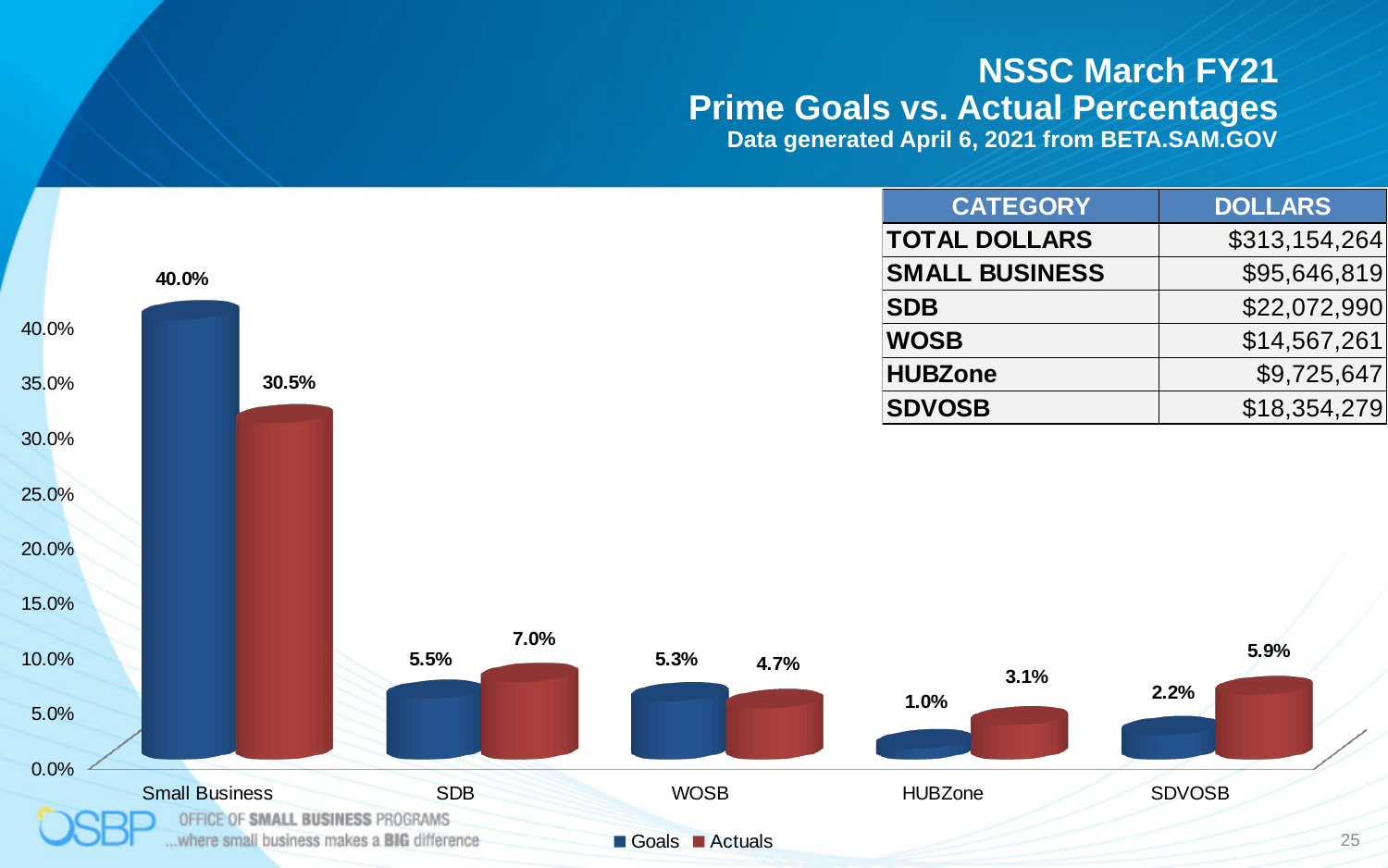
What is the Goals value for SDVOSB? 2.2% What kind of chart is shown on the slide? Bar chart How many series does the legend list? 2 How many categories are shown on the x axis? 5 What is the Actuals value for HUBZone? 3.1% What is the Actuals value for SDB? 7.0% Which category has the lowest Goals value? HUBZone Which category has the highest Actuals value? Small Business What is the difference between the Goals and Actuals values for Small Business? 9.5% What colour are the Actuals bars? Red What is the Goals value for Small Business? 40.0% Which is larger for WOSB, the Goals value or the Actuals value? Goals